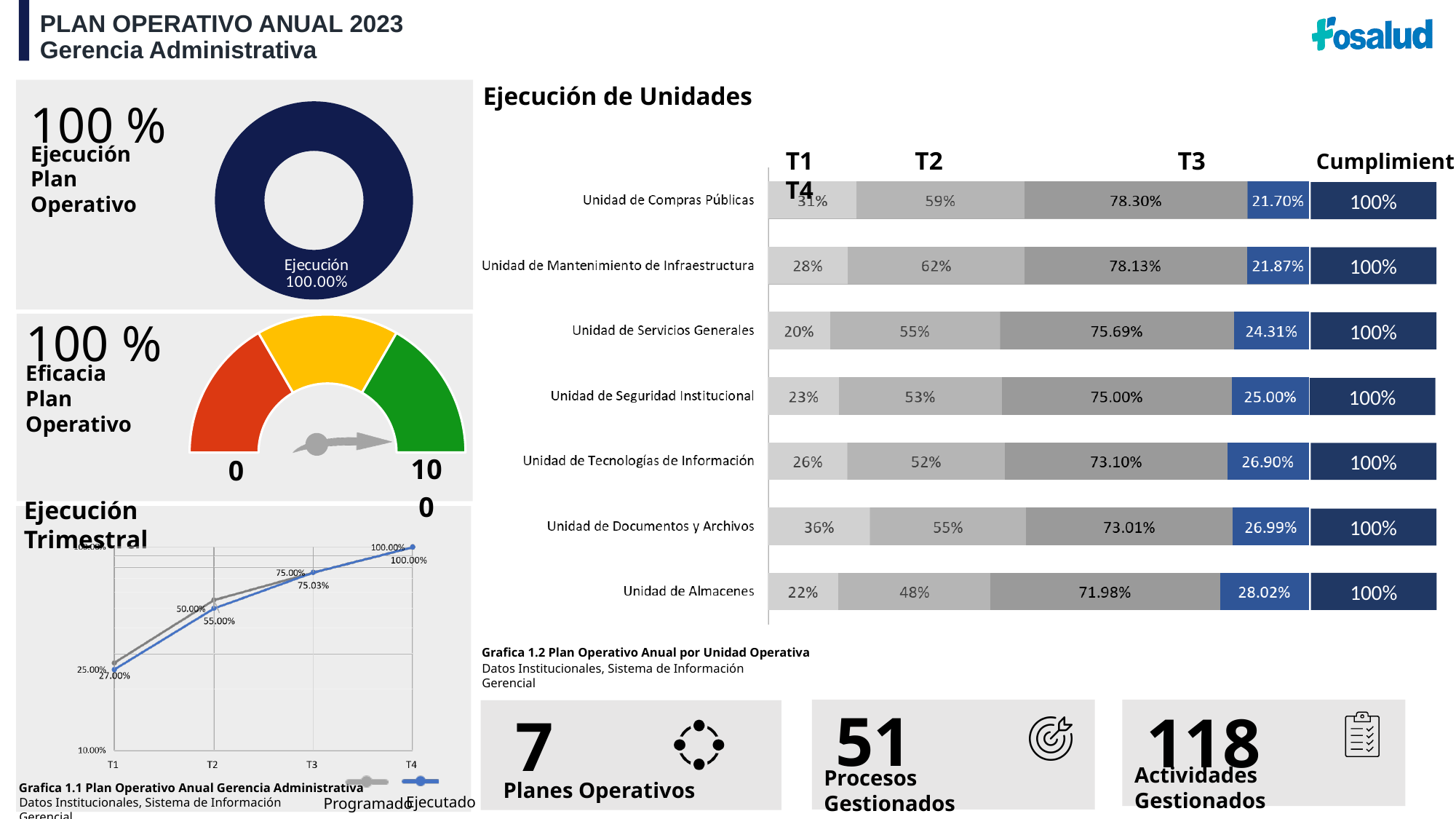
In the 'Ejecución Trimestral' line chart, do the values rise or fall from T1 to T4? Rise What kind of chart is 'Ejecución de Unidades'? Bar chart How many units are listed in the 'Ejecución de Unidades' chart? 7 In the 'Ejecución Trimestral' line chart, what is the Ejecutado value at T2? 55.00% In the 'Ejecución de Unidades' bar chart, what is the T1 value for Unidad de Documentos y Archivos? 36% In the 'Ejecución de Unidades' bar chart, which unit has the highest T1 value? Unidad de Documentos y Archivos In the 'Ejecución de Unidades' bar chart, what is the difference between the T2 value for Unidad de Compras Públicas and the T2 value for Unidad de Almacenes? 11 percentage points How many series does the legend of the 'Ejecución Trimestral' line chart list? 2 In the 'Ejecución de Unidades' bar chart, which unit has the lowest T1 value? Unidad de Servicios Generales In the 'Ejecución de Unidades' bar chart, what is the T3 value for Unidad de Almacenes? 71.98% In the 'Ejecución de Unidades' bar chart, what is the T4 value for Unidad de Tecnologías de Información? 26.90% In the 'Ejecución de Unidades' bar chart, which has the larger T4 value: Unidad de Almacenes or Unidad de Compras Públicas? Unidad de Almacenes